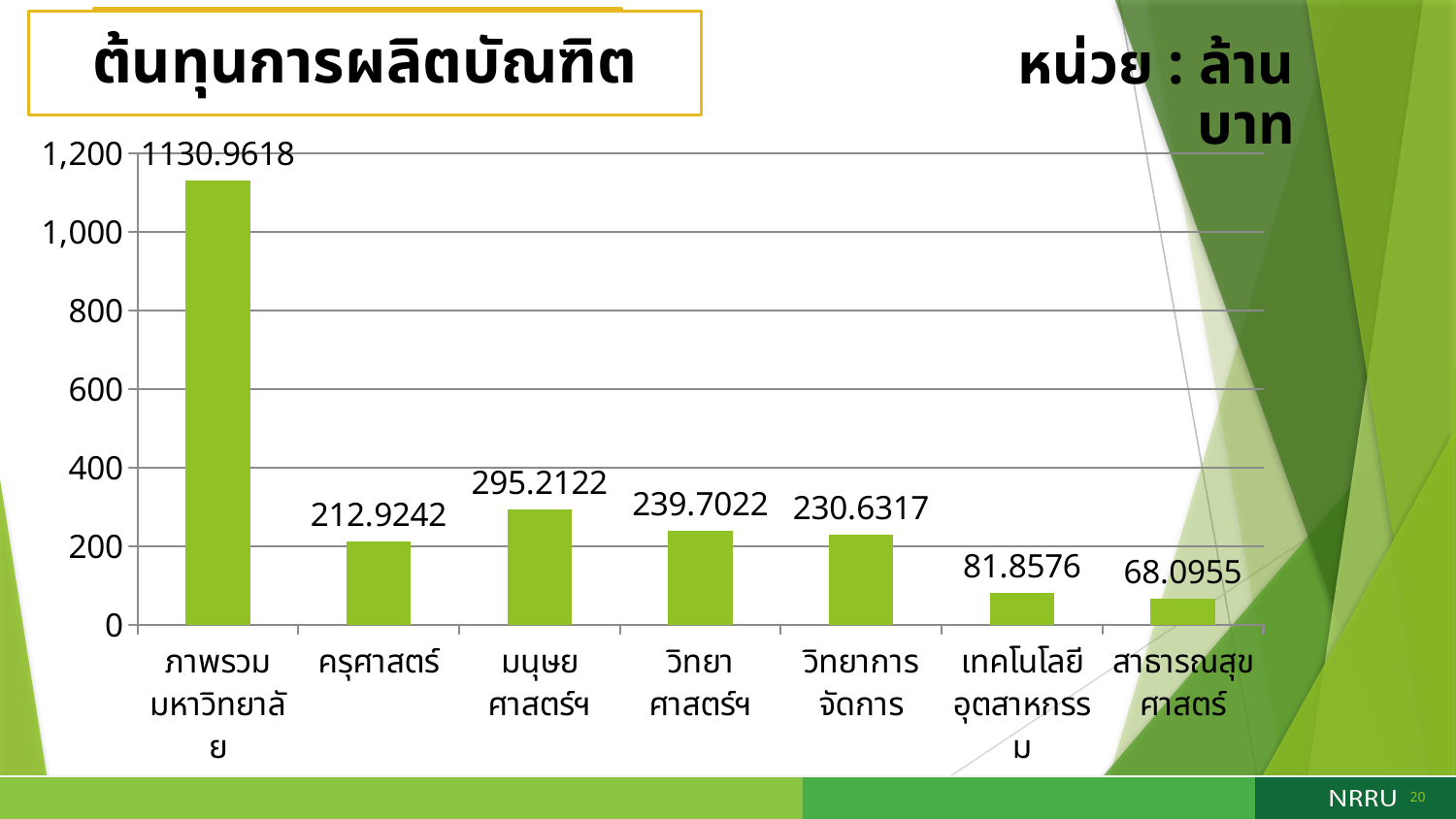
What is the value for มนุษยศาสตร์ฯ? 295.2122 What kind of chart is shown on the slide? bar chart How many categories are shown in the chart? 7 What is the value for ครุศาสตร์? 212.9242 Which is larger, the value for วิทยาศาสตร์ฯ or the value for วิทยาการจัดการ? วิทยาศาสตร์ฯ Which category has the highest value? ภาพรวมมหาวิทยาลัย What is the difference between the values for เทคโนโลยีอุตสาหกรรม and สาธารณสุขศาสตร์? 13.7621 What is the title of the chart? ต้นทุนการผลิตบัณฑิต Which category has the lowest value? สาธารณสุขศาสตร์ What is the value for ภาพรวมมหาวิทยาลัย? 1130.9618 What is the value for เทคโนโลยีอุตสาหกรรม? 81.8576 What is the difference between the values for มนุษยศาสตร์ฯ and ครุศาสตร์? 82.2880